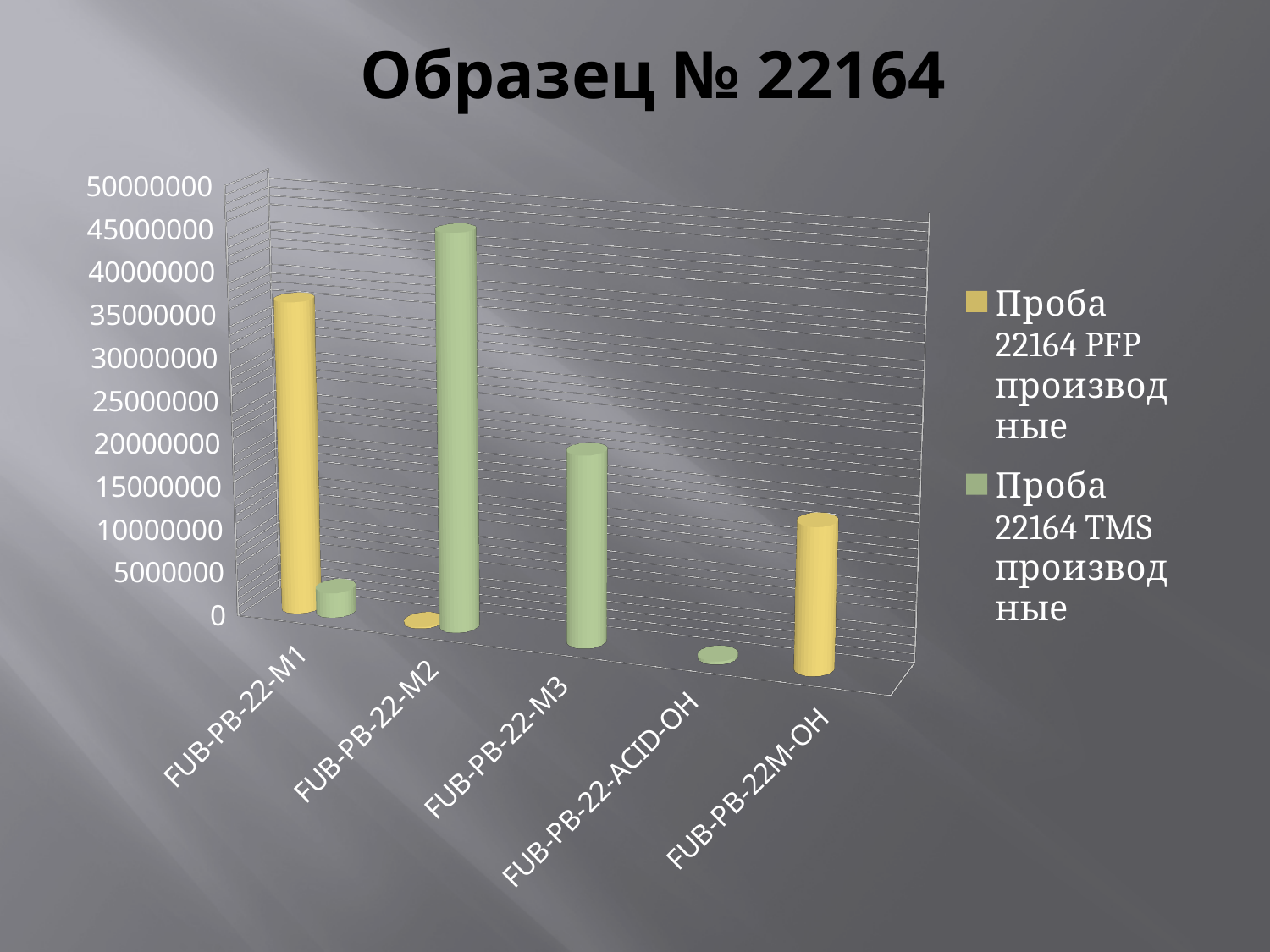
How many categories are shown on the x axis? 5 Is the value for FUB-PB-22M-OH in the series 'Проба 22164 PFP производные' greater or less than 20000000? less Which category has the highest value for the series 'Проба 22164 PFP производные'? FUB-PB-22-M1 How many series does the legend list? 2 What is the title of the chart on the slide? Образец № 22164 For FUB-PB-22-M1, which series has the larger value: 'Проба 22164 PFP производные' or 'Проба 22164 TMS производные'? Проба 22164 PFP производные What kind of chart is shown on the slide? bar chart Which category has the highest value for the series 'Проба 22164 TMS производные'? FUB-PB-22-M2 Is the value for FUB-PB-22-M3 in the series 'Проба 22164 TMS производные' greater or less than 10000000? greater Is the value for FUB-PB-22-M2 in the series 'Проба 22164 TMS производные' greater or less than 40000000? greater For FUB-PB-22-M2, which series has the larger value: 'Проба 22164 PFP производные' or 'Проба 22164 TMS производные'? Проба 22164 TMS производные